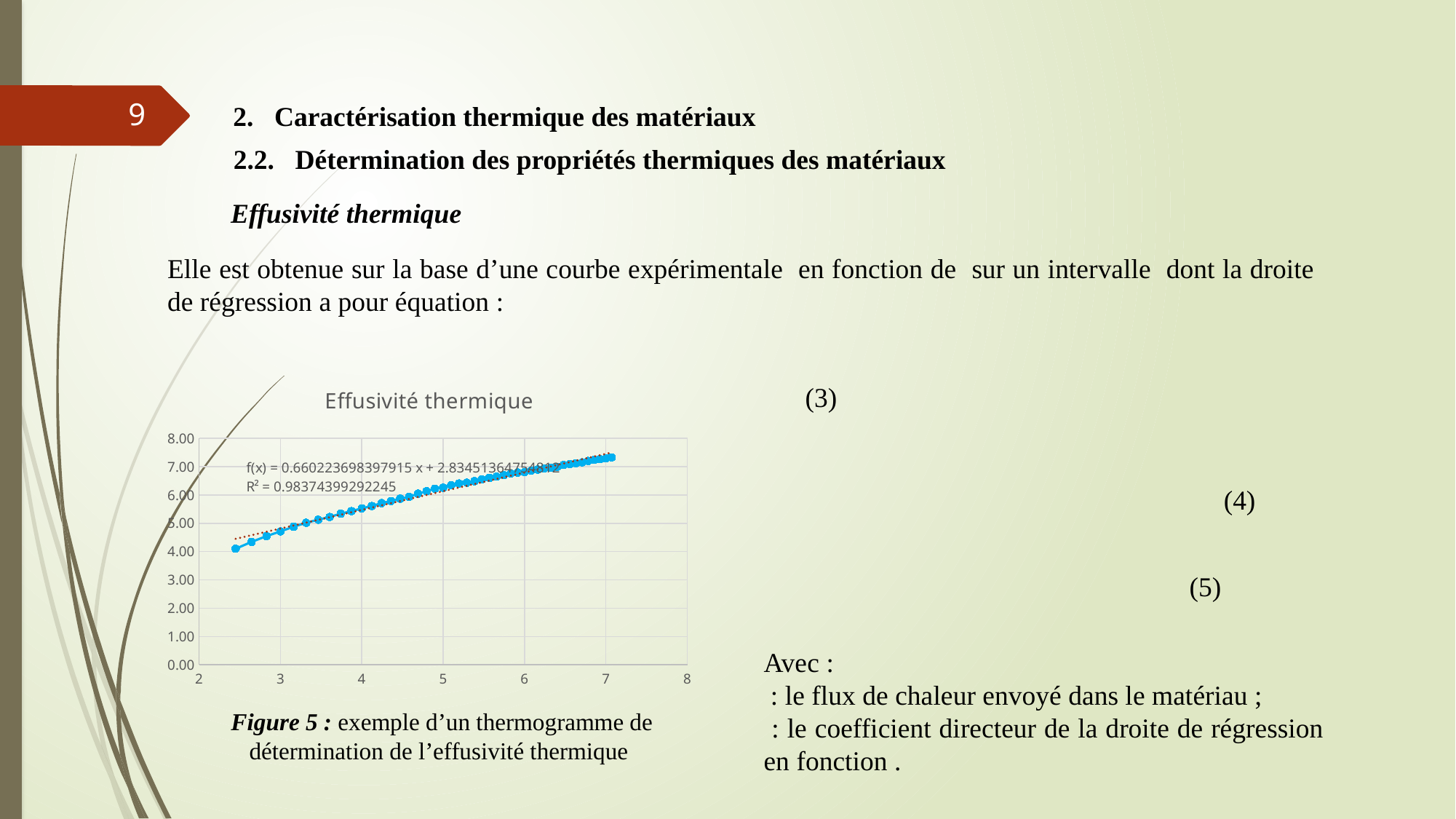
Do the plotted values rise or fall as x increases from 2 to 7? rise Is the plotted value at x = 4 greater or less than 6.00? less What R² value is printed on the chart? R² = 0.98374399292245 Which plotted point has the highest value: the one near x = 3 or the one near x = 6? the one near x = 6 Is the plotted value at x = 5 greater or less than 6.00? greater What kind of chart is shown on the slide? line chart What is the maximum value shown on the y axis of the chart? 8.00 Is the value of the last plotted point (near x = 7) greater or less than 7.00? greater What is the title of the chart on the slide? Effusivité thermique What is the trendline equation printed on the chart? f(x) = 0.660223698397915 x + 2.83451364754812